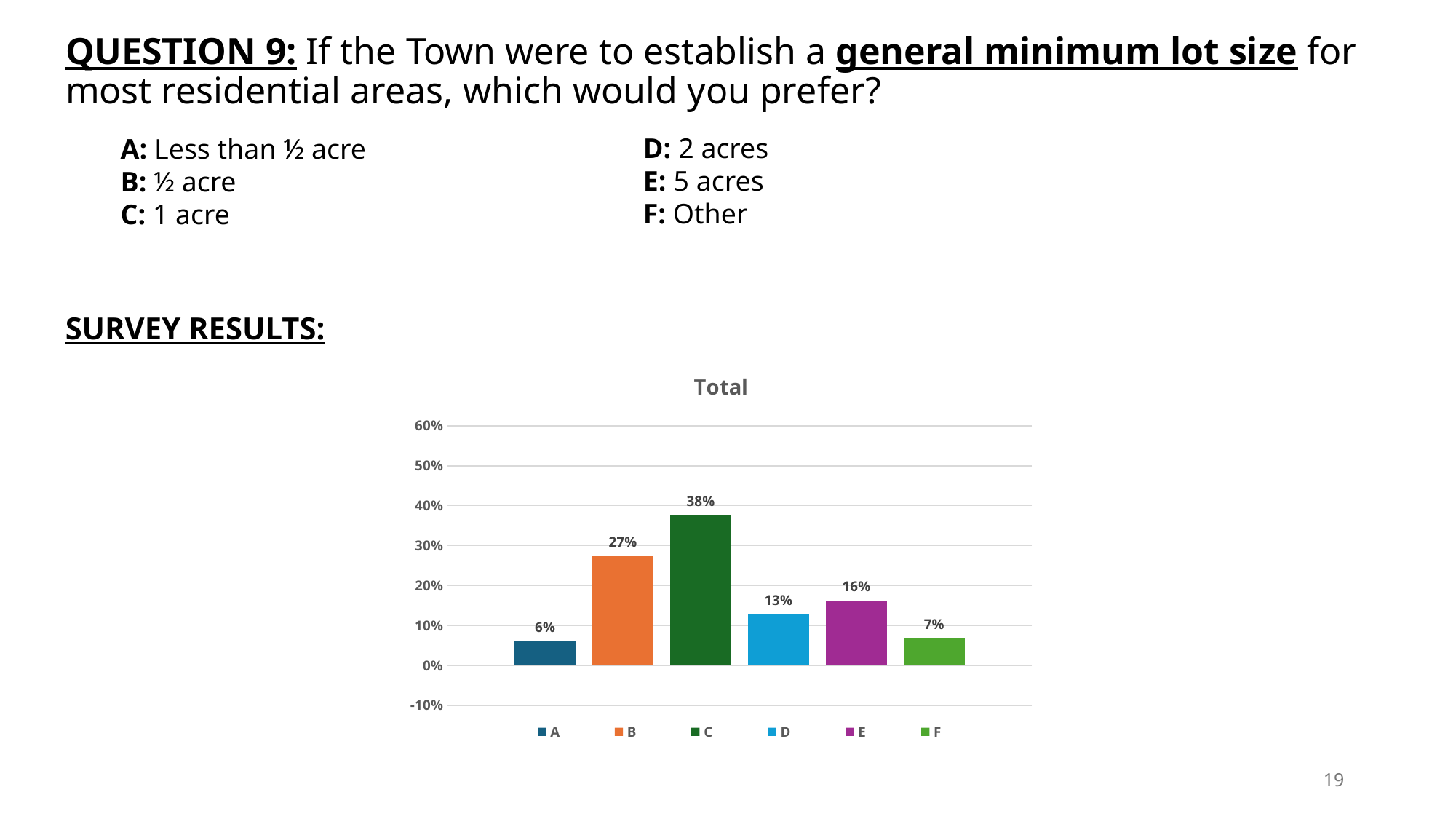
What kind of chart is shown? bar chart Is the value for B greater or less than 20%? greater How many categories are shown in the chart? 6 What is the value for category C? 38% What is the value for category A? 6% Which category has the highest value? C How many entries does the legend list? 6 What is the title of the chart? Total Which is larger, the value for D or the value for E? E What is the difference between the values for C and B? 11% Which category has the lowest value? A What is the value for category E? 16%